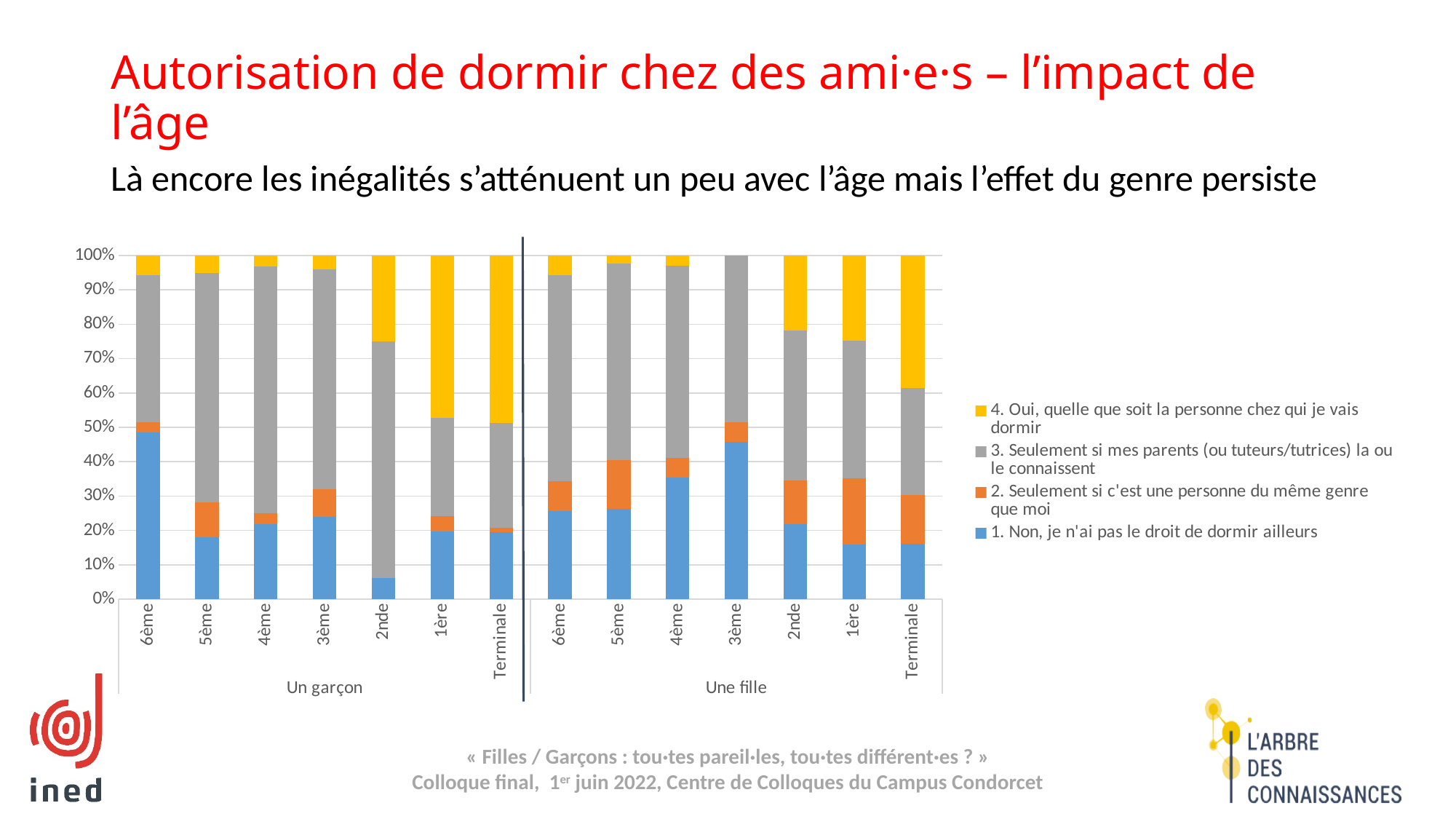
How many grade levels are shown for the group 'Un garçon'? 7 Among the 'Un garçon' bars, which grade has the largest share of '1. Non, je n'ai pas le droit de dormir ailleurs'? 6ème Among the 'Une fille' bars, which grade has the largest share of '1. Non, je n'ai pas le droit de dormir ailleurs'? 3ème What kind of chart is shown on the slide? Stacked bar chart For 6ème, is the share of '1. Non, je n'ai pas le droit de dormir ailleurs' larger for 'Un garçon' or 'Une fille'? Un garçon Is the share of '1. Non, je n'ai pas le droit de dormir ailleurs' for 2nde boys greater or less than 10%? less How many bars are plotted in the chart in total? 14 How many series does the legend list? 4 Which colour represents '1. Non, je n'ai pas le droit de dormir ailleurs' in the chart? Blue Is the share of '1. Non, je n'ai pas le droit de dormir ailleurs' for 6ème boys greater or less than 40%? greater Is the share of '4. Oui, quelle que soit la personne chez qui je vais dormir' for Terminale boys greater or less than 40%? greater Among the 'Un garçon' bars, which grade has the smallest share of '1. Non, je n'ai pas le droit de dormir ailleurs'? 2nde